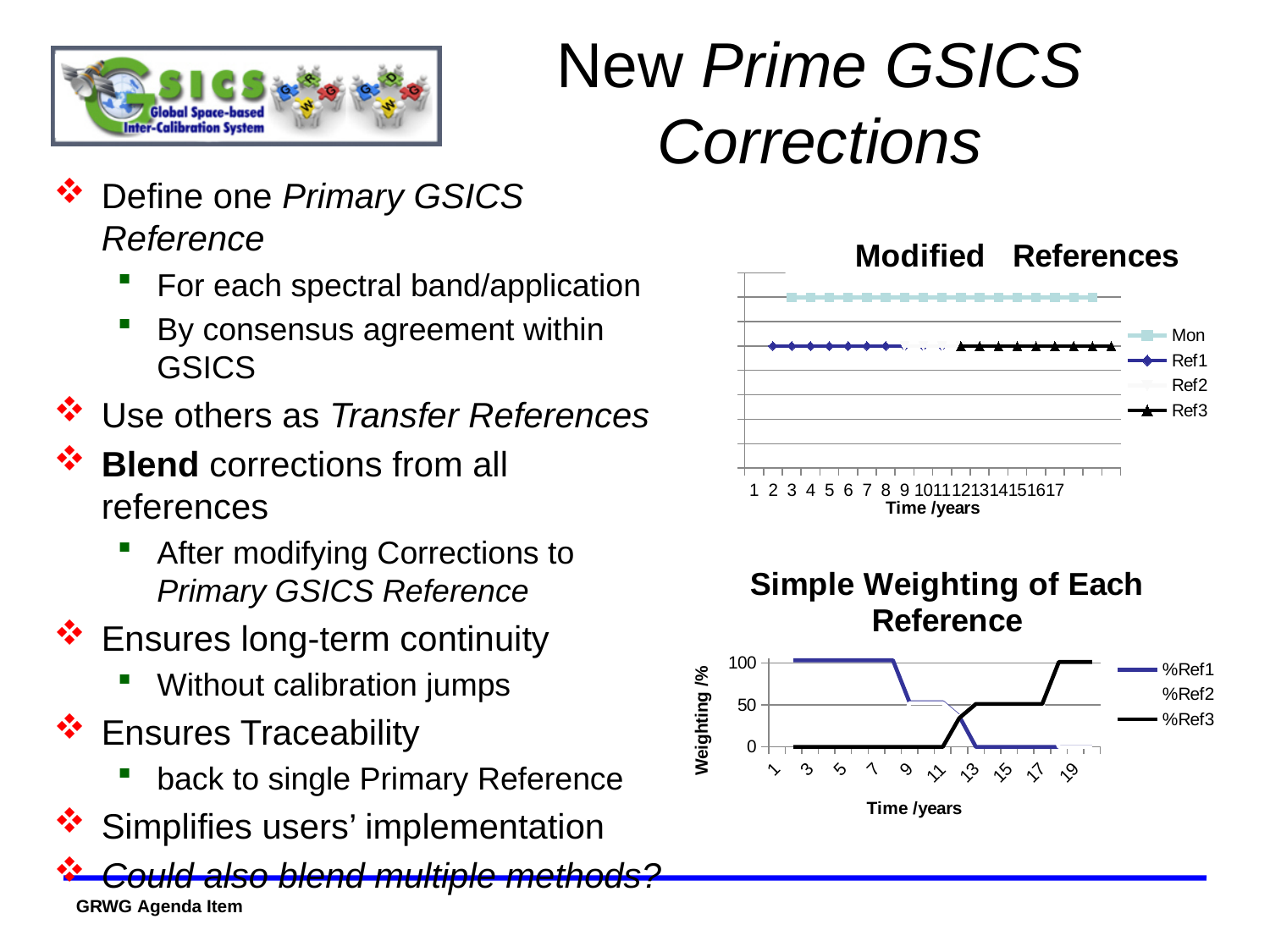
How many series does the legend of the "Simple Weighting of Each Reference" chart list? 3 In the "Simple Weighting of Each Reference" chart, which series has the larger weighting at year 5, %Ref1 or %Ref3? %Ref1 In the "Simple Weighting of Each Reference" chart, is the %Ref3 weighting at year 5 greater or less than 50? less How many series does the legend of the "Modified References" chart list? 4 In the "Simple Weighting of Each Reference" chart, does the %Ref1 weighting rise or fall as time increases? fall What are the legend entries of the "Modified References" chart? Mon, Ref1, Ref2, Ref3 In the "Simple Weighting of Each Reference" chart, is the %Ref1 weighting at year 17 greater or less than 50? less What kind of chart is the "Simple Weighting of Each Reference" chart? line chart What is the y-axis title of the "Simple Weighting of Each Reference" chart? Weighting /% In the "Simple Weighting of Each Reference" chart, does the %Ref3 weighting rise or fall as time increases? rise